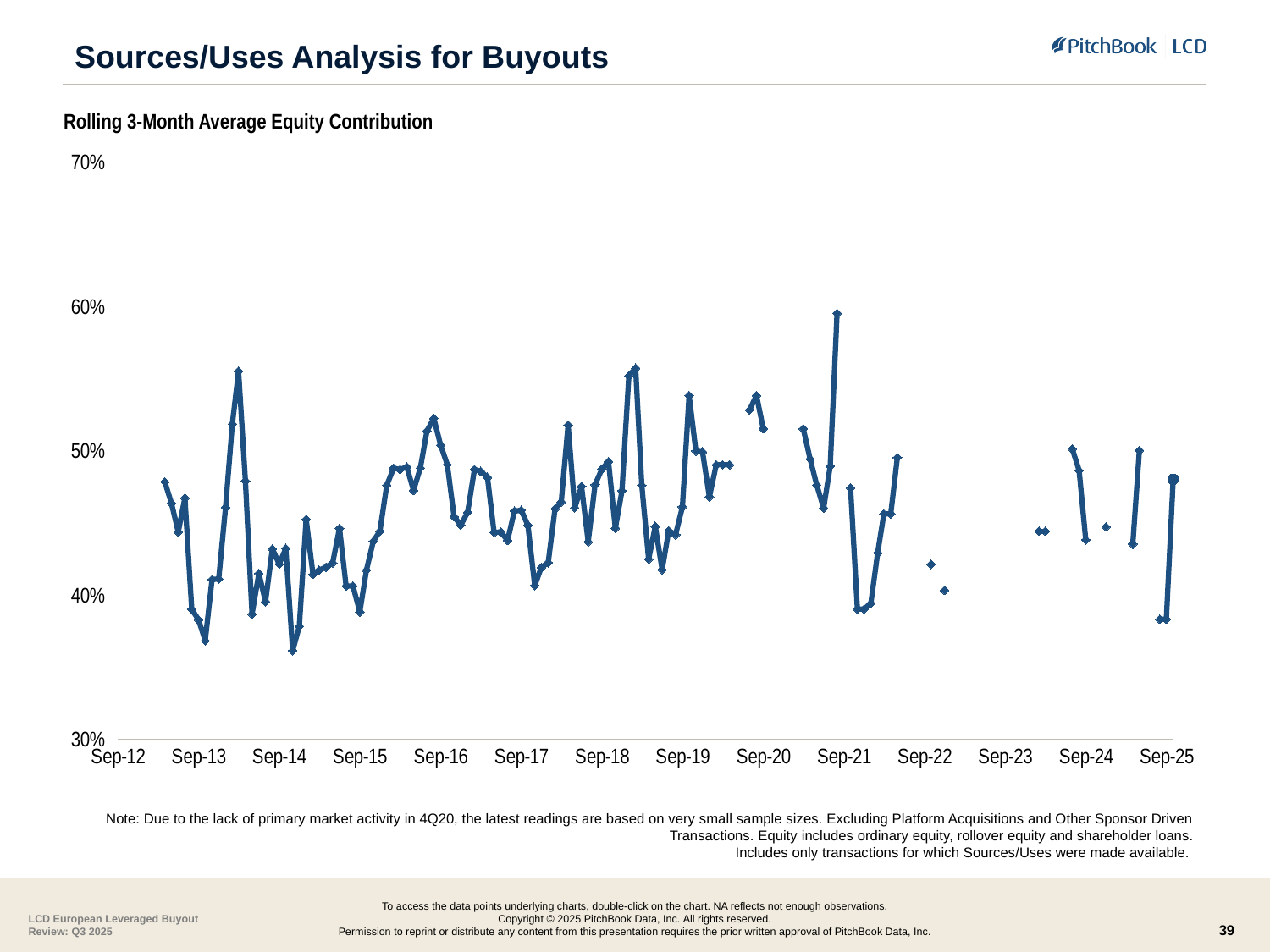
What is the highest value shown on the y axis? 70% What is the lowest value shown on the y axis? 30% What is the title of the chart? Rolling 3-Month Average Equity Contribution What kind of chart is shown on the slide? Line chart What is the last date label on the x axis? Sep-25 Near which x-axis label does the line reach its highest point? Sep-21 Is the value at the peak near Sep-21 larger or smaller than the value at the low point between Sep-13 and Sep-14? larger How many date labels are shown on the x axis? 14 Is the peak value of the line, reached shortly after Sep-21, greater or less than 50%? greater Is the lowest value of the line, reached between Sep-13 and Sep-14, greater or less than 40%? less What is the first date label on the x axis? Sep-12 Is the value at the final point of the line, near Sep-25, greater or less than 40%? greater